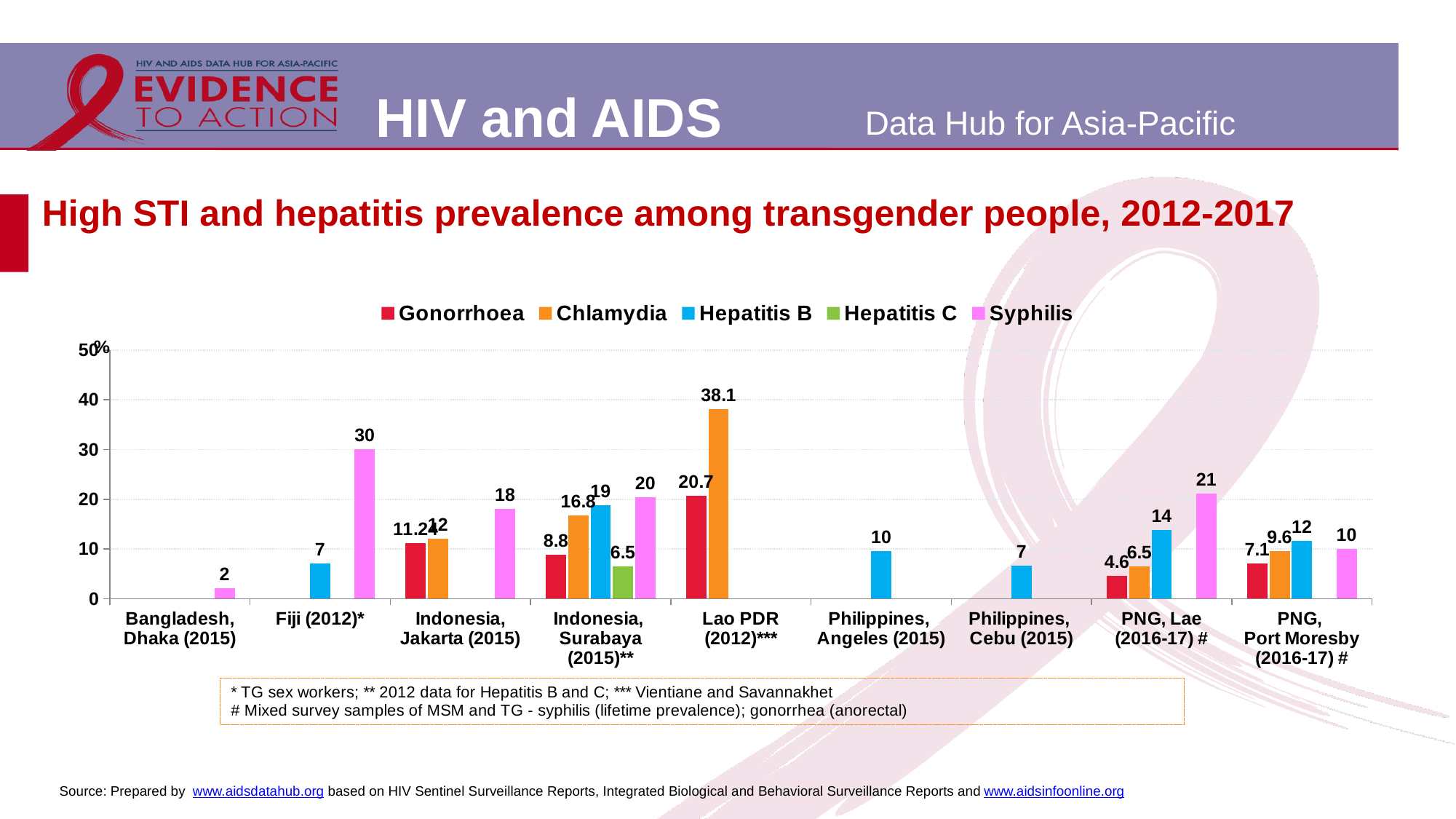
Which category has the lowest Syphilis value? Bangladesh, Dhaka (2015) How many categories are shown on the x axis? 9 What is the Hepatitis C value for Indonesia, Surabaya (2015)**? 6.5 What is the Syphilis value for Fiji (2012)*? 30 What is the Chlamydia value for Lao PDR (2012)***? 38.1 How many series does the legend list? 5 Which is larger for PNG, Port Moresby (2016-17) #: the Hepatitis B value or the Syphilis value? Hepatitis B Which series is shown in green in the legend? Hepatitis C What is the difference between the Chlamydia and Gonorrhoea values for Lao PDR (2012)***? 17.4 Which category has the highest Syphilis value? Fiji (2012)* What kind of chart is shown on the slide? Bar chart What is the Gonorrhoea value for PNG, Lae (2016-17) #? 4.6